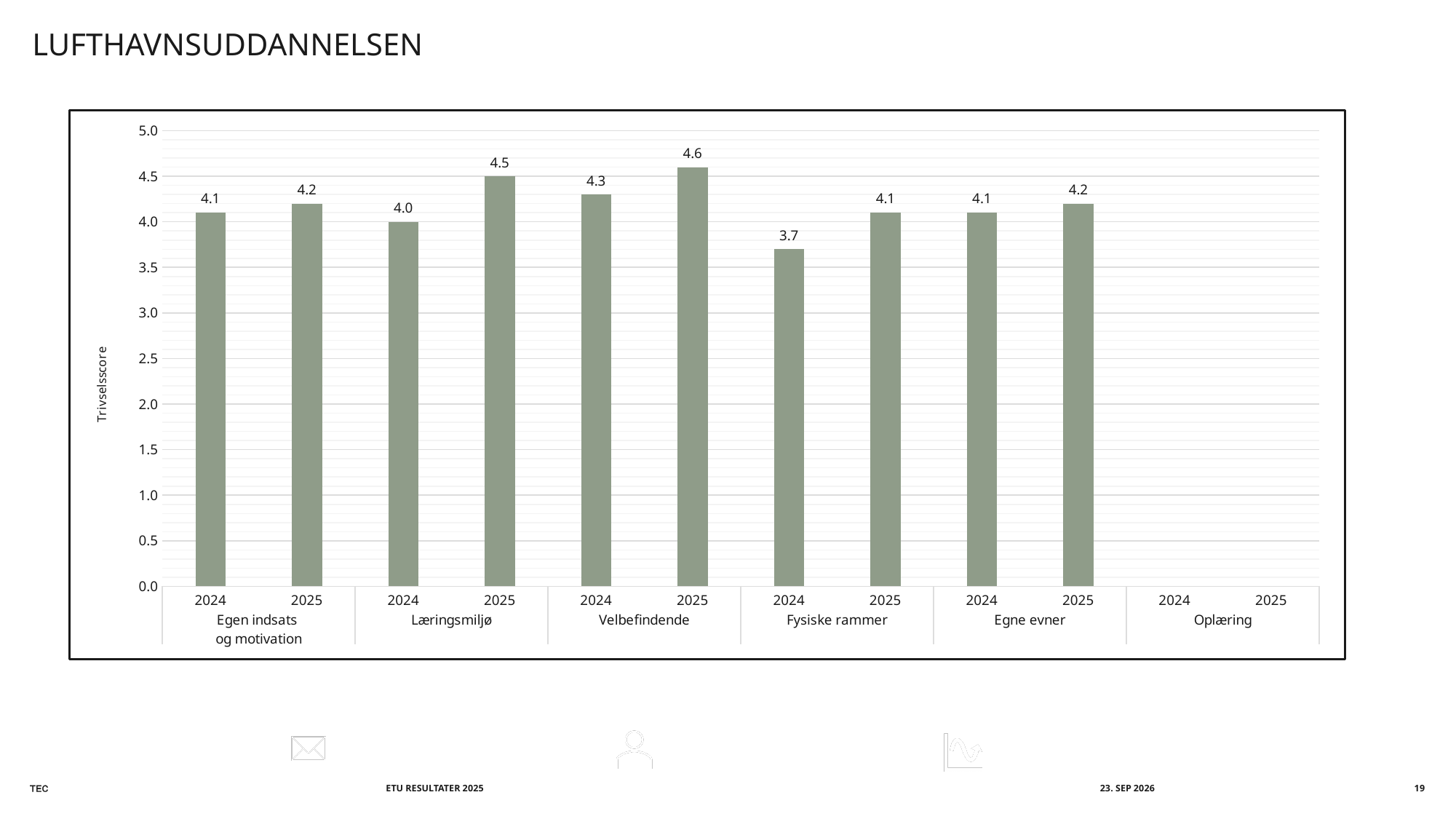
What is the 2024 value for Egen indsats og motivation? 4.1 What is the 2024 value for Fysiske rammer? 3.7 Which bar has the highest value in the chart? Velbefindende 2025 Is the 2024 value for Fysiske rammer greater or less than 4.0? less What is the difference between the 2025 and 2024 values for Læringsmiljø? 0.5 Which bar has the lowest value in the chart? Fysiske rammer 2024 What is the 2025 value for Læringsmiljø? 4.5 What is the label of the vertical axis? Trivselsscore What type of chart is shown on the slide? bar chart What is the difference between the 2025 and 2024 values for Fysiske rammer? 0.4 Which is larger: the 2024 value for Velbefindende or the 2024 value for Læringsmiljø? Velbefindende 2024 What is the 2025 value for Velbefindende? 4.6